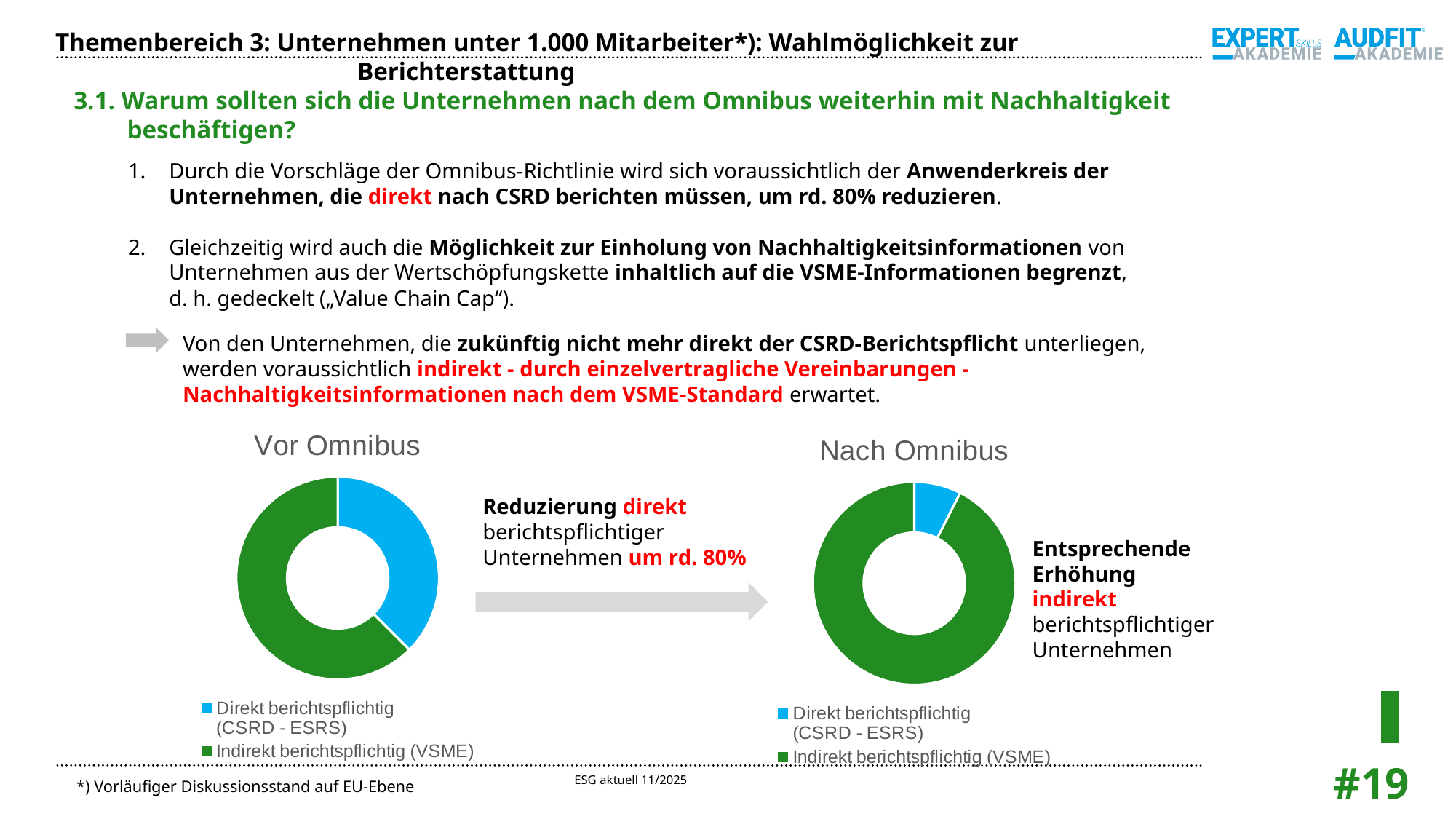
In the "Nach Omnibus" chart, which category has the largest slice? Indirekt berichtspflichtig (VSME) In the "Vor Omnibus" chart, how many categories does the legend list? 2 In the "Nach Omnibus" chart, how many categories does the legend list? 2 What kind of chart is the "Vor Omnibus" chart? Doughnut chart What kind of chart is the "Nach Omnibus" chart? Doughnut chart Is the "Direkt berichtspflichtig (CSRD - ESRS)" slice larger in the "Vor Omnibus" chart or in the "Nach Omnibus" chart? Vor Omnibus In the "Vor Omnibus" chart, which category has the largest slice? Indirekt berichtspflichtig (VSME) In the "Nach Omnibus" chart, which category has the smallest slice? Direkt berichtspflichtig (CSRD - ESRS) In the "Nach Omnibus" chart, what colour represents "Indirekt berichtspflichtig (VSME)"? Green What is the title of the chart on the left side of the slide? Vor Omnibus In the "Vor Omnibus" chart, which category has the smallest slice? Direkt berichtspflichtig (CSRD - ESRS) Is the "Indirekt berichtspflichtig (VSME)" slice larger in the "Vor Omnibus" chart or in the "Nach Omnibus" chart? Nach Omnibus